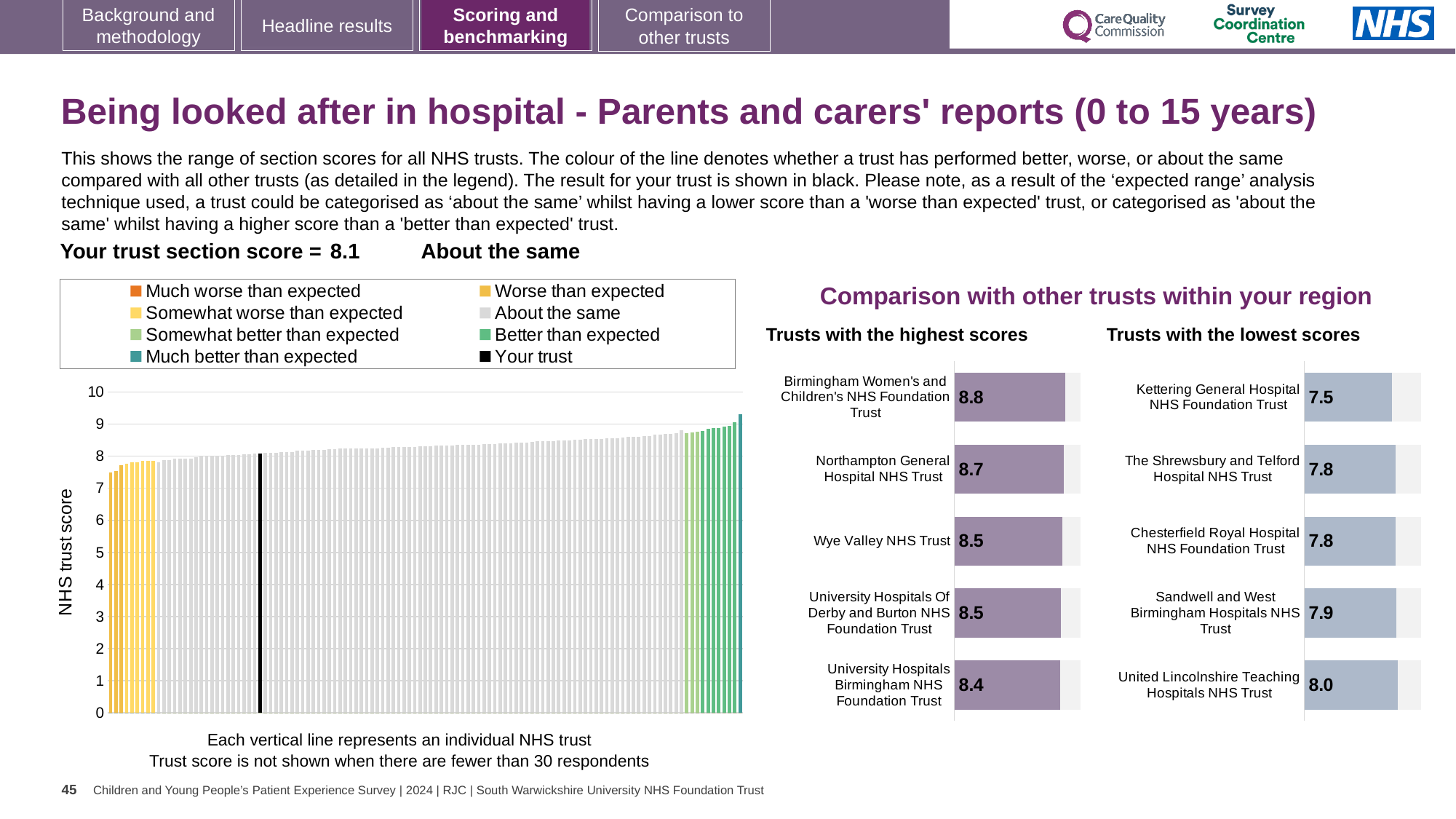
In the 'Trusts with the lowest scores' chart, what is the score for Kettering General Hospital NHS Foundation Trust? 7.5 In the 'Trusts with the highest scores' chart, what is the difference between the scores of Northampton General Hospital NHS Trust and University Hospitals Birmingham NHS Foundation Trust? 0.3 In the 'NHS trust score' chart on the left, do the values rise or fall from left to right? rise In the 'Trusts with the lowest scores' chart, what is the difference between the scores of United Lincolnshire Teaching Hospitals NHS Trust and Kettering General Hospital NHS Foundation Trust? 0.5 What kind of chart is the 'NHS trust score' chart on the left of the slide? bar chart How many trusts are shown in the 'Trusts with the highest scores' chart? 5 In the 'Trusts with the highest scores' chart, which trust has the highest score? Birmingham Women's and Children's NHS Foundation Trust How many entries does the legend of the 'NHS trust score' chart on the left list? 8 What is the section score for your trust shown on the slide? 8.1 In the 'Trusts with the lowest scores' chart, which has the higher score: Sandwell and West Birmingham Hospitals NHS Trust or Chesterfield Royal Hospital NHS Foundation Trust? Sandwell and West Birmingham Hospitals NHS Trust In the 'Trusts with the highest scores' chart, what is the score for Birmingham Women's and Children's NHS Foundation Trust? 8.8 In the 'Trusts with the lowest scores' chart, which trust has the lowest score? Kettering General Hospital NHS Foundation Trust